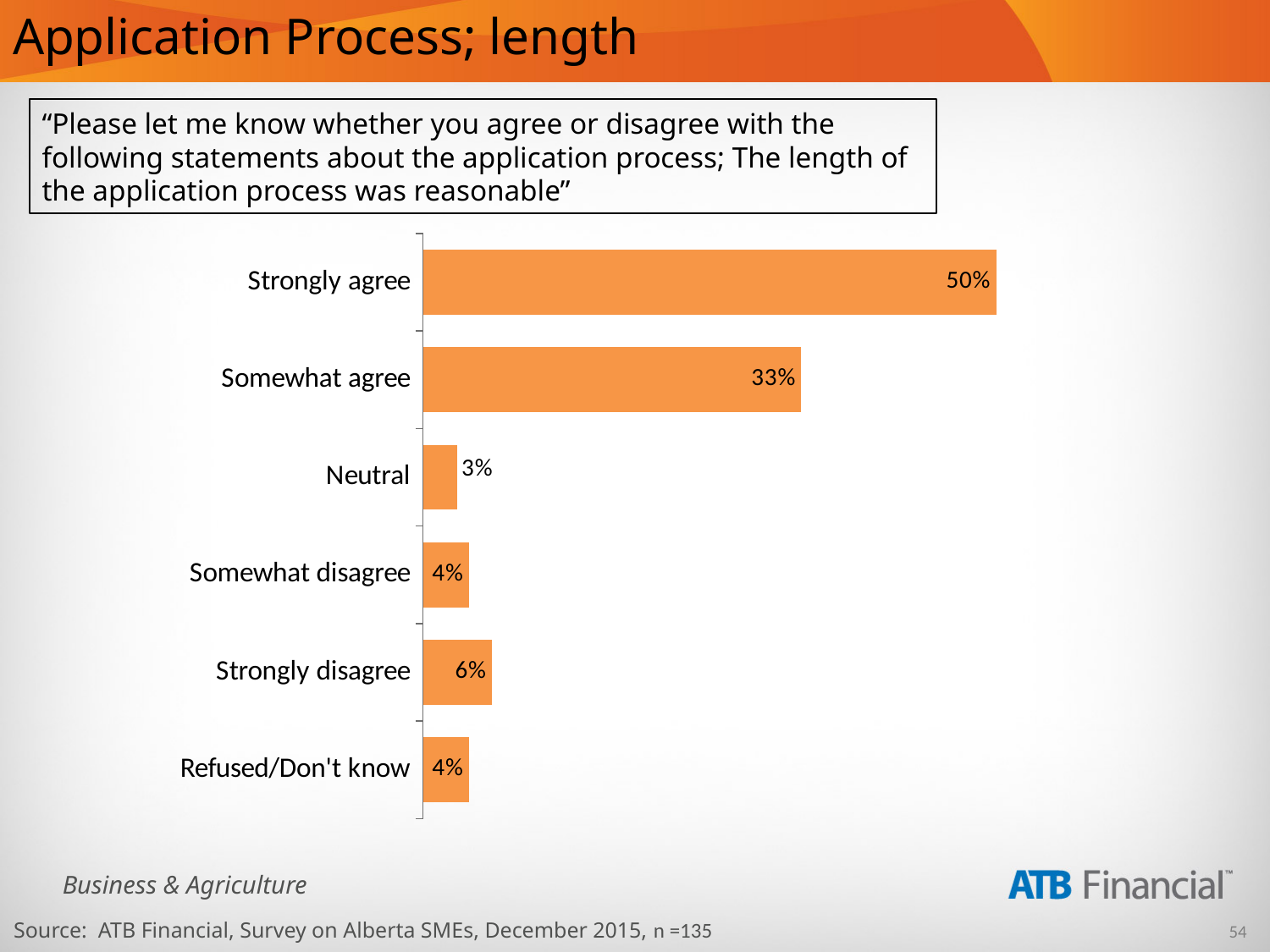
How many categories are shown in the chart? 6 What is the value shown for Strongly disagree? 6% Which category has the highest value? Strongly agree What is the value shown for Somewhat agree? 33% What kind of chart is shown on the slide? Bar chart What is the difference between the Strongly agree and Somewhat agree values? 17% Which is larger, the value for Strongly disagree or the value for Somewhat disagree? Strongly disagree What is the value shown for Neutral? 3% What percentage of respondents strongly agree that the length of the application process was reasonable? 50% What is the combined value of Strongly agree and Somewhat agree? 83% What is the value shown for Refused/Don't know? 4% Which category has the lowest value? Neutral